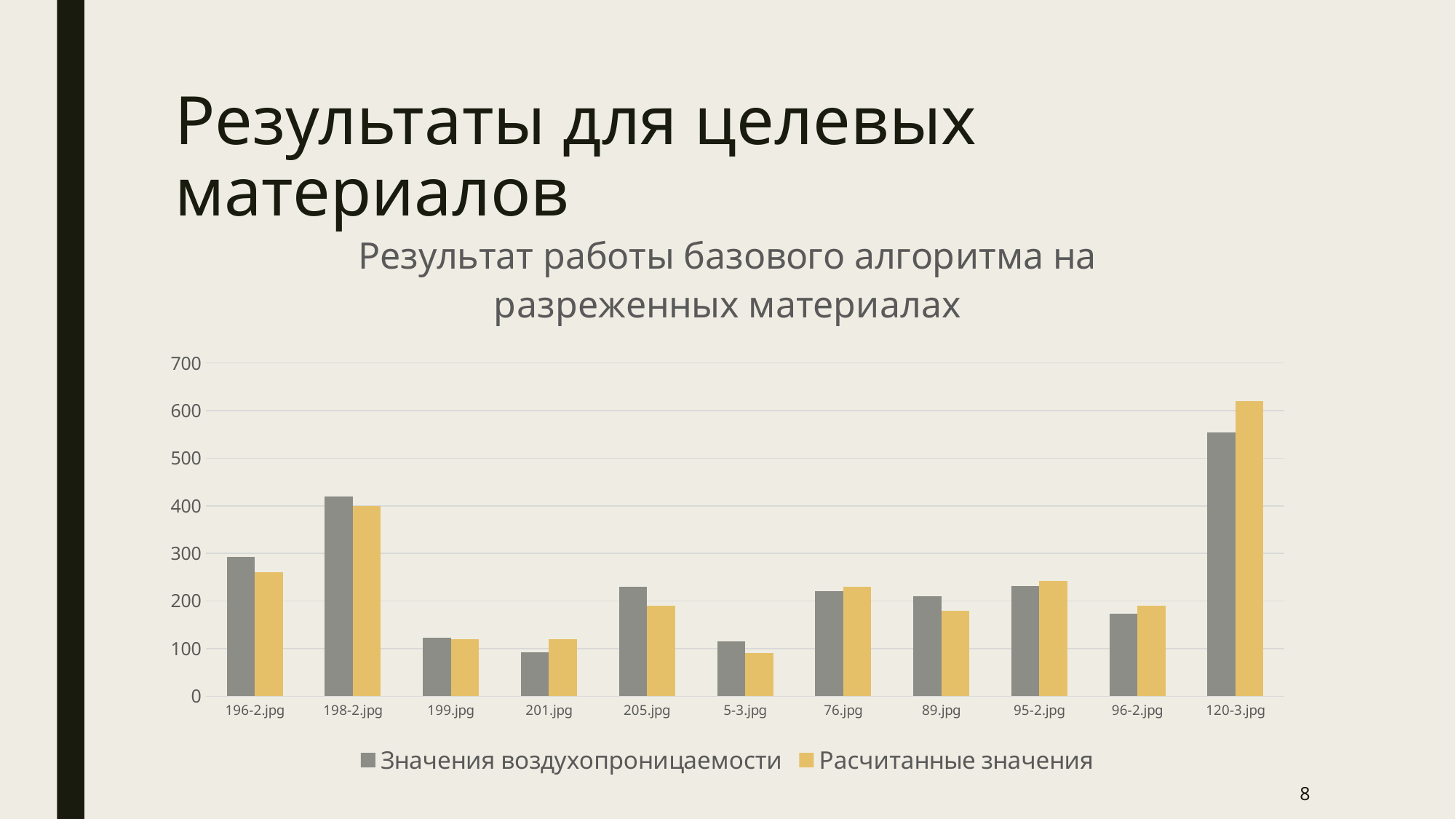
Which category has the lowest value for Значения воздухопроницаемости? 201.jpg What is the title of the chart? Результат работы базового алгоритма на разреженных материалах How many series does the chart's legend list? 2 Which category has the lowest value for Расчитанные значения? 5-3.jpg For 196-2.jpg, which series has the larger value: Значения воздухопроницаемости or Расчитанные значения? Значения воздухопроницаемости How many categories are shown on the x axis of the chart? 11 For 201.jpg, which series has the larger value: Значения воздухопроницаемости or Расчитанные значения? Расчитанные значения Is the value of Значения воздухопроницаемости for 198-2.jpg greater or less than 400? greater Is the value of Расчитанные значения for 205.jpg greater or less than 200? less Which category has the highest value for Значения воздухопроницаемости? 120-3.jpg Is the value of Расчитанные значения for 120-3.jpg greater or less than 600? greater What kind of chart is shown on the slide? bar chart